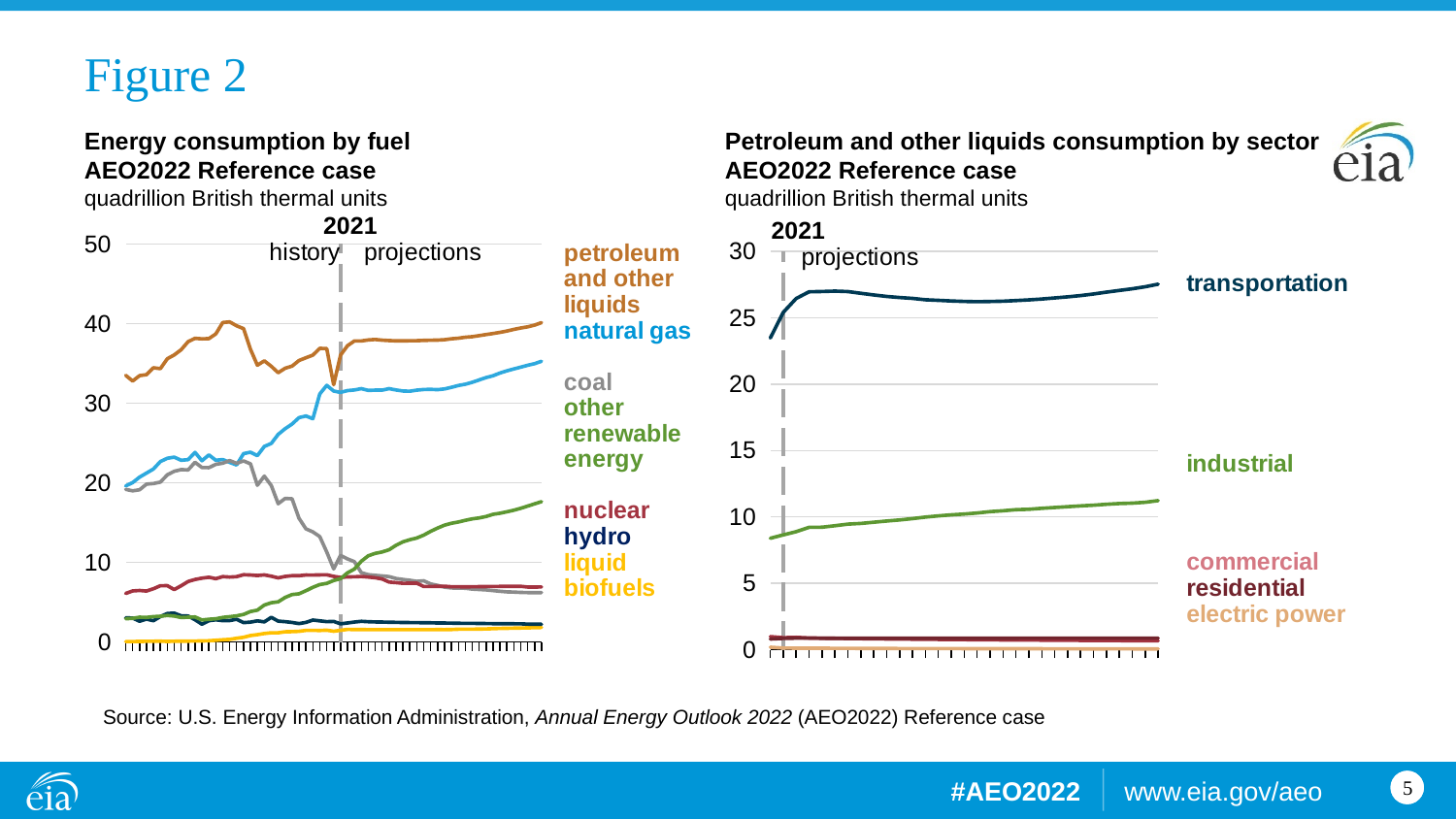
On the left chart, 'Energy consumption by fuel', which fuel has the highest consumption at the end of the projection period? petroleum and other liquids On the left chart, 'Energy consumption by fuel', does other renewable energy rise or fall over the projection period? rise How many fuel series are labelled on the left chart, 'Energy consumption by fuel'? 7 On the left chart, 'Energy consumption by fuel', is the value for natural gas at the end of the projection period greater or less than 30? greater How many sector series are labelled on the right chart, 'Petroleum and other liquids consumption by sector'? 5 On the right chart, 'Petroleum and other liquids consumption by sector', which sector has the highest consumption? transportation What year does the vertical dashed line on both charts mark? 2021 On the right chart, 'Petroleum and other liquids consumption by sector', is the value for industrial at the end of the projection period greater or less than 10? greater On the right chart, 'Petroleum and other liquids consumption by sector', does industrial consumption rise or fall over the projection period? rise On the left chart, 'Energy consumption by fuel', is the value for coal at the end of the projection period greater or less than 10? less What kind of chart is the left chart, 'Energy consumption by fuel'? line chart